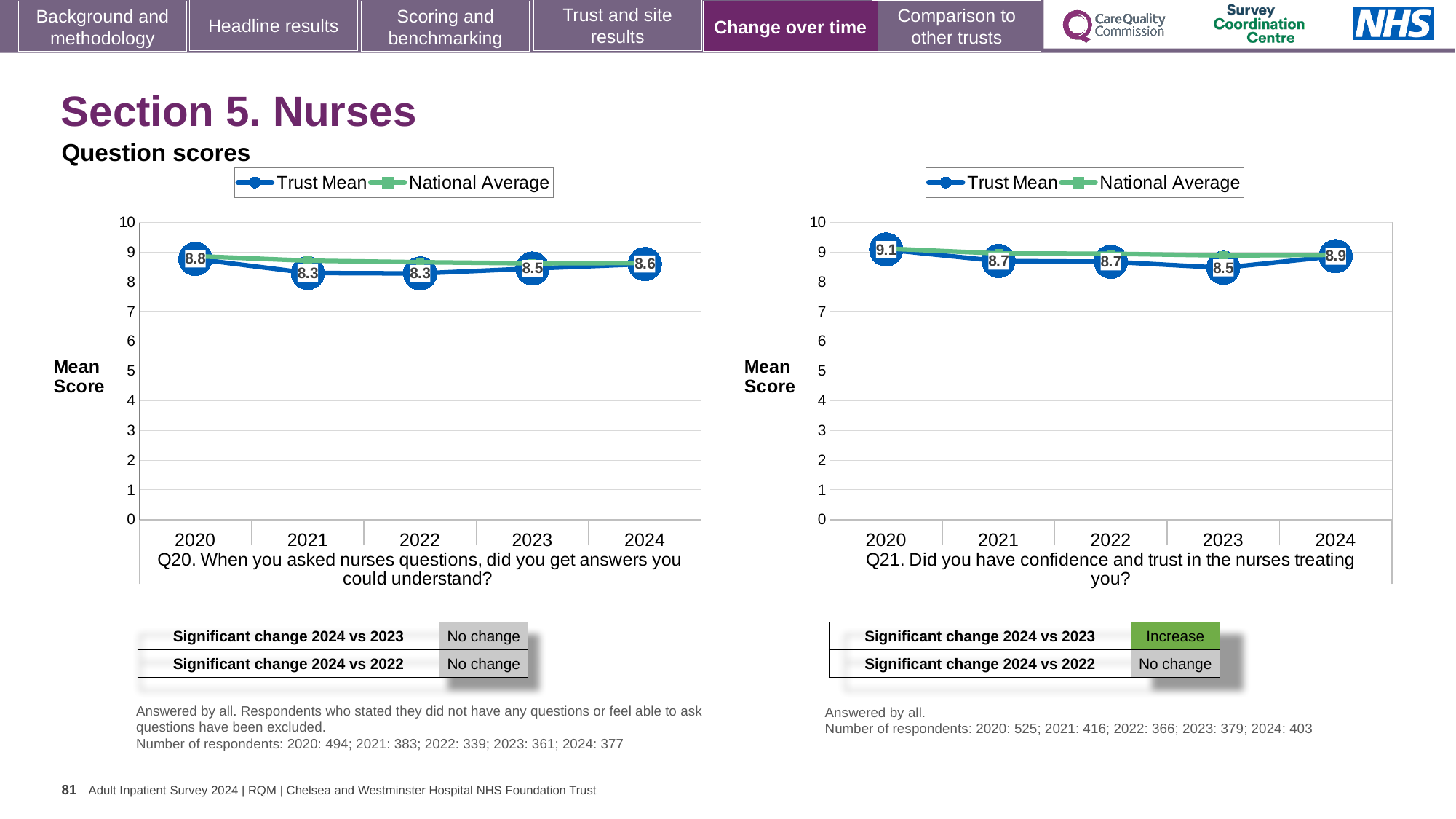
In the Q21 chart (right), what is the Trust Mean score for 2023? 8.5 In the Q20 chart (left), what is the Trust Mean score for 2024? 8.6 In the Q21 chart (right), what is the Trust Mean score for 2020? 9.1 In the Q20 chart (left), which year has the highest Trust Mean score? 2020 How many series does the legend of the Q20 chart (left) list? 2 What type of chart is the Q21 chart (right)? Line chart In the Q20 chart (left), how many years are plotted on the x axis? 5 In the Q20 chart (left), what is the difference between the Trust Mean scores for 2020 and 2021? 0.5 In the Q21 chart (right), which year has the lowest Trust Mean score? 2023 In the Q20 chart (left), what is the Trust Mean score for 2020? 8.8 In the Q21 chart (right), is the Trust Mean score for 2024 larger or smaller than the score for 2023? larger In the Q21 chart (right), what is the difference between the Trust Mean scores for 2024 and 2023? 0.4